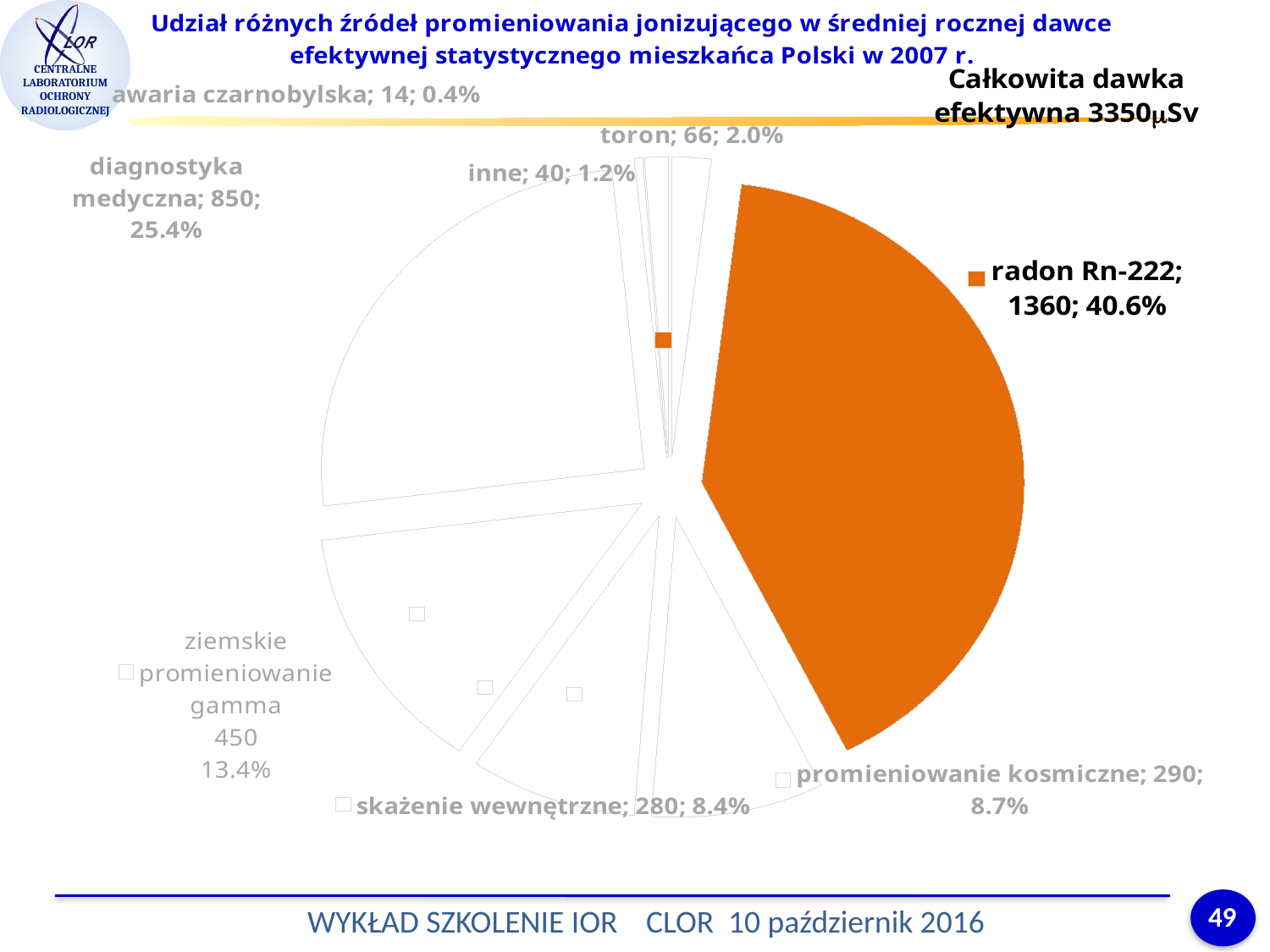
What kind of chart is shown on the slide? pie chart What is the value for radon Rn-222? 1360 What is the difference between the values for promieniowanie kosmiczne and skażenie wewnętrzne? 10 What share of the pie does diagnostyka medyczna represent? 25.4% Which slice of the pie is coloured orange? radon Rn-222 What is the difference between the values for radon Rn-222 and diagnostyka medyczna? 510 What is the value for promieniowanie kosmiczne? 290 Which is larger, the value for toron or the value for inne? toron Which category has the largest slice of the pie? radon Rn-222 What share of the pie does ziemskie promieniowanie gamma represent? 13.4% Which category has the smallest slice of the pie? awaria czarnobylska How many categories are shown in the pie chart? 8